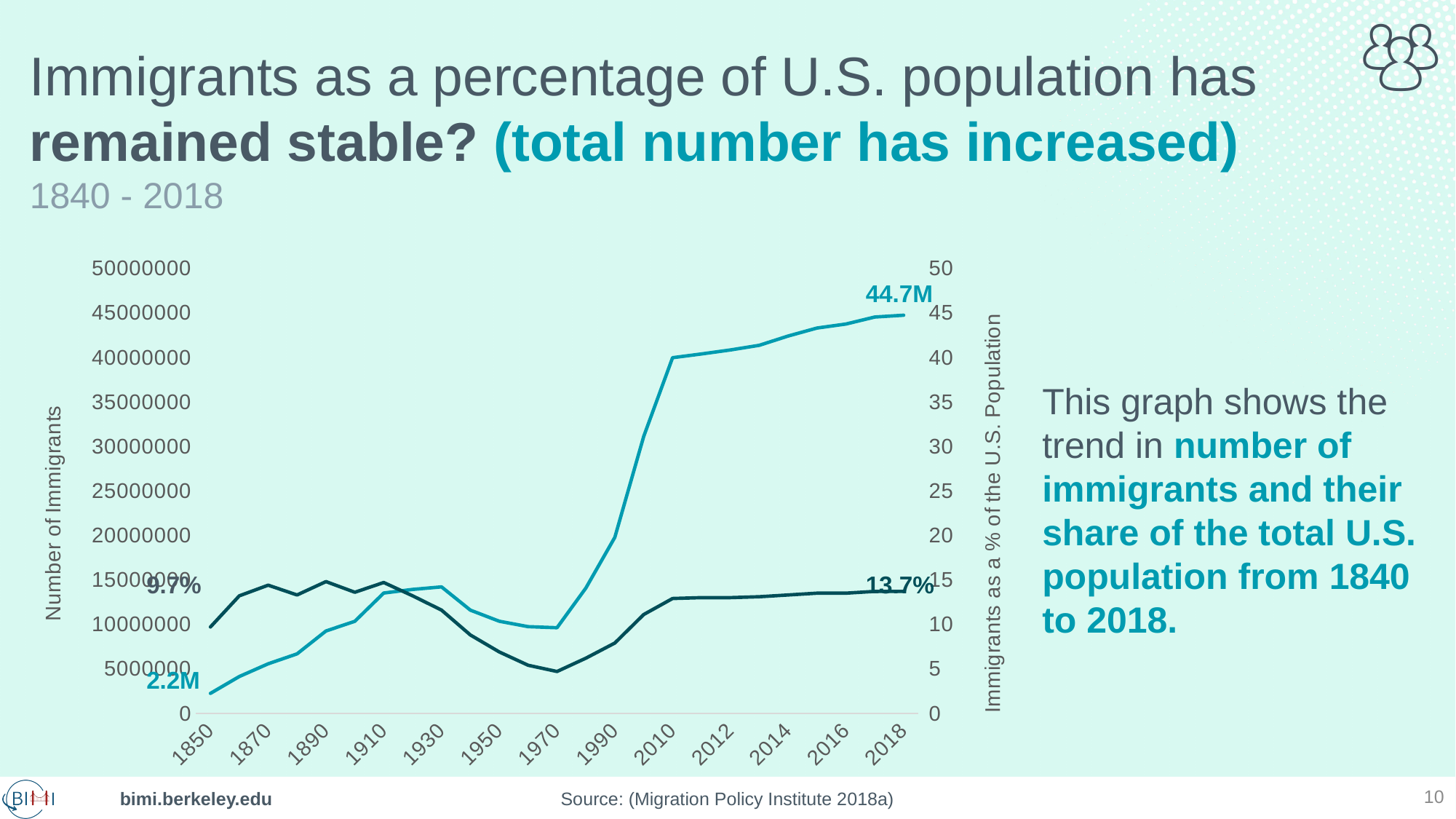
What is the title of the left vertical axis? Number of Immigrants By how much did the number of immigrants grow between the 2.2M label and the 44.7M label? 42.5M Is the immigrant share of the U.S. population in 1970 greater or less than 10? less Which is larger, the immigrant share of the U.S. population in 1850 or in 2018? 2018 What percentage of the U.S. population were immigrants at the start of the series in 1850? 9.7% What is the number of immigrants labelled at the start of the series in 1850? 2.2M What kind of chart is shown on the slide? Line chart Is the number of immigrants in 2010 greater or less than 35000000? greater How many year labels are shown on the x axis? 13 What is the number of immigrants labelled at the end of the series in 2018? 44.7M What percentage of the U.S. population were immigrants at the end of the series in 2018? 13.7% Does the number of immigrants rise or fall overall from 1850 to 2018? Rise